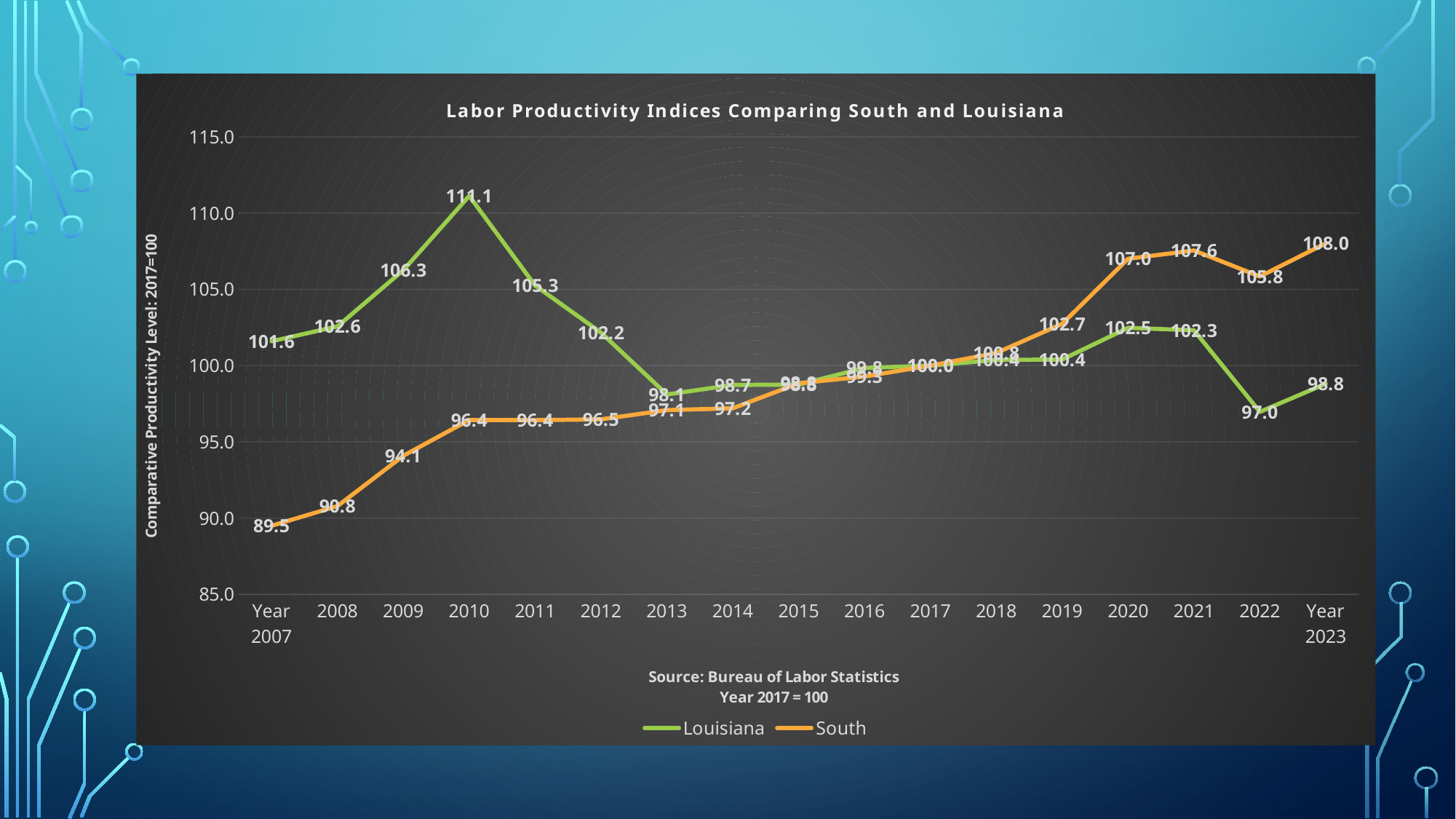
Is the South value in 2009 greater or less than 95.0? less In which year is the South series at its lowest value? Year 2007 What is the Louisiana value in 2010? 111.1 What is the South value in Year 2023? 108.0 What is the Louisiana value in 2022? 97.0 What is the difference between the Louisiana and South values in 2010? 14.7 Which series has the higher value in 2021, Louisiana or South? South What kind of chart is shown on the slide? line chart How many series does the legend list? 2 How many years are plotted on the x axis? 17 What is the South value in Year 2007? 89.5 In which year does the Louisiana series reach its highest value? 2010